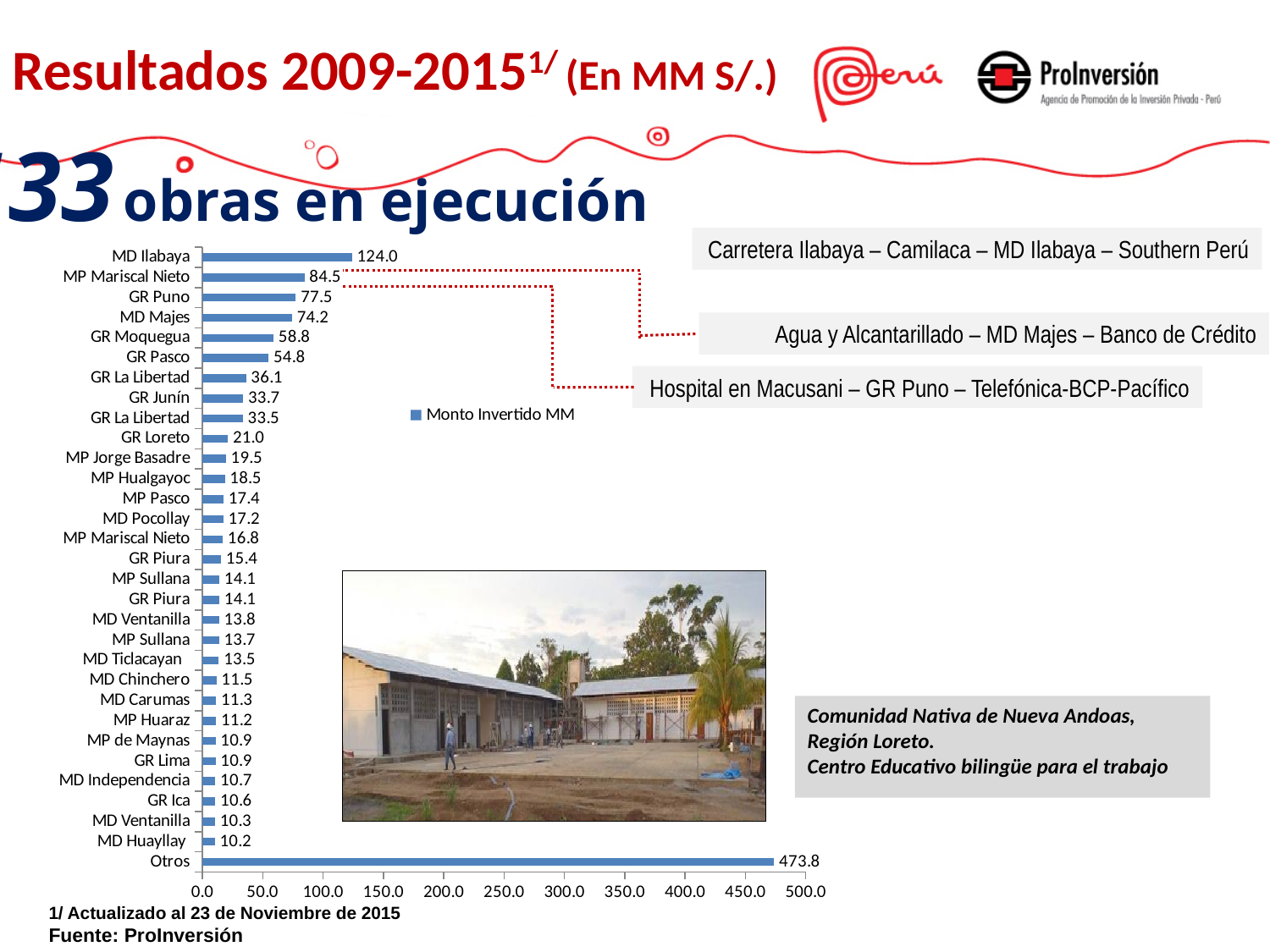
Which category has the lowest value? MD Huayllay Is the value for Otros greater or less than 450.0? greater What is the difference between the values for MD Ilabaya and GR Puno? 46.5 What is the value for GR Moquegua? 58.8 What is the value for MD Ticlacayan? 13.5 What kind of chart is shown? bar chart Which is larger, the value for MD Majes or the value for GR Pasco? MD Majes Which category has the highest value? Otros How many series does the legend list? 1 What is the value for GR Loreto? 21.0 What is the value for MD Ilabaya? 124.0 How many categories are shown in the chart? 31